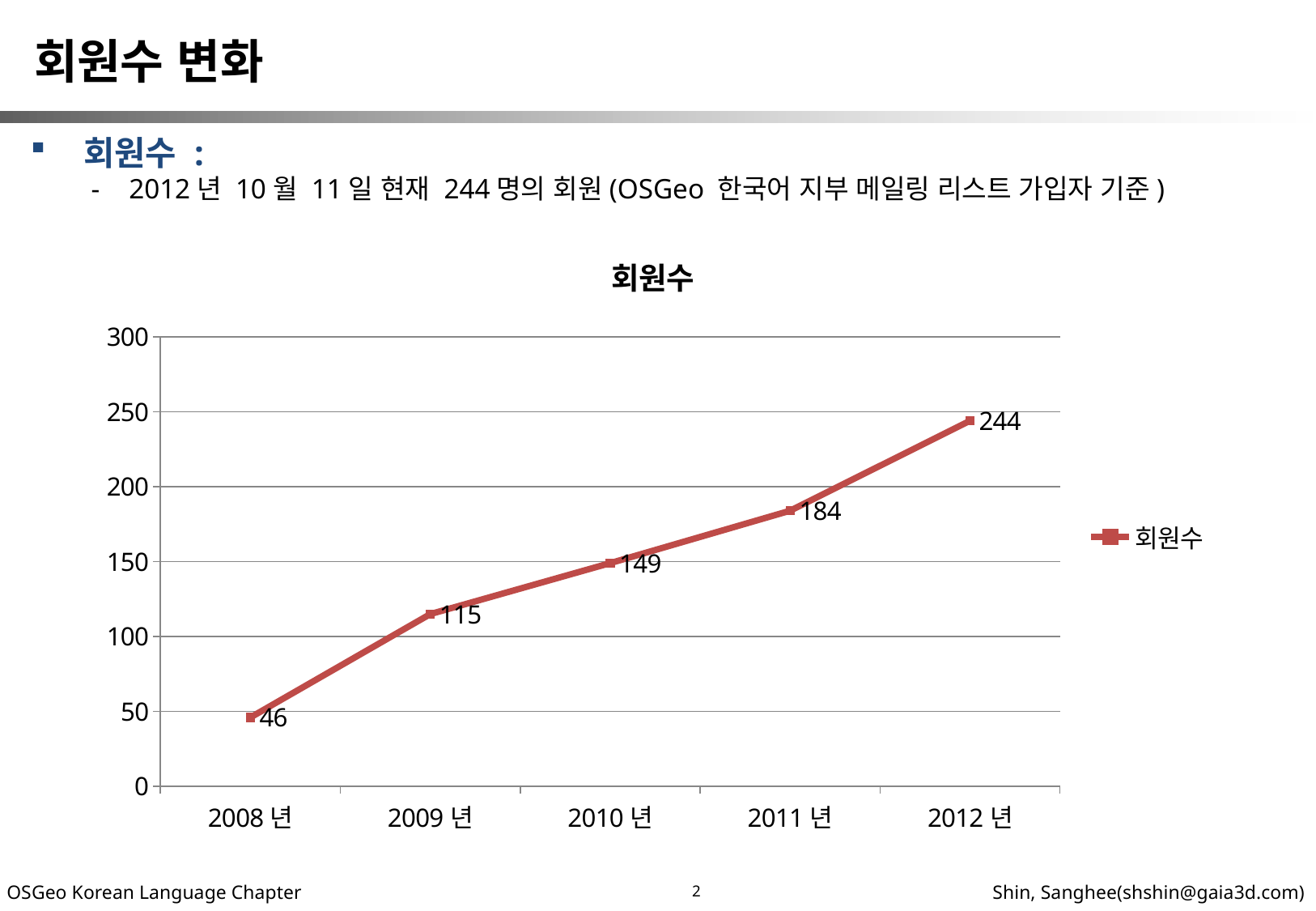
What kind of chart is shown? line chart Is the value for 2011 년 greater or less than 150? greater Which year has the lowest value? 2008 년 Do the values rise or fall from 2008 년 to 2012 년? rise What is the value for 2010 년? 149 What is the difference between the values for 2012 년 and 2011 년? 60 What is the difference between the values for 2009 년 and 2008 년? 69 Which year has the highest value? 2012 년 How many years are plotted on the x axis? 5 Which is larger, the value for 2010 년 or the value for 2011 년? 2011 년 What is the value for 2008 년? 46 What is the value for 2012 년? 244